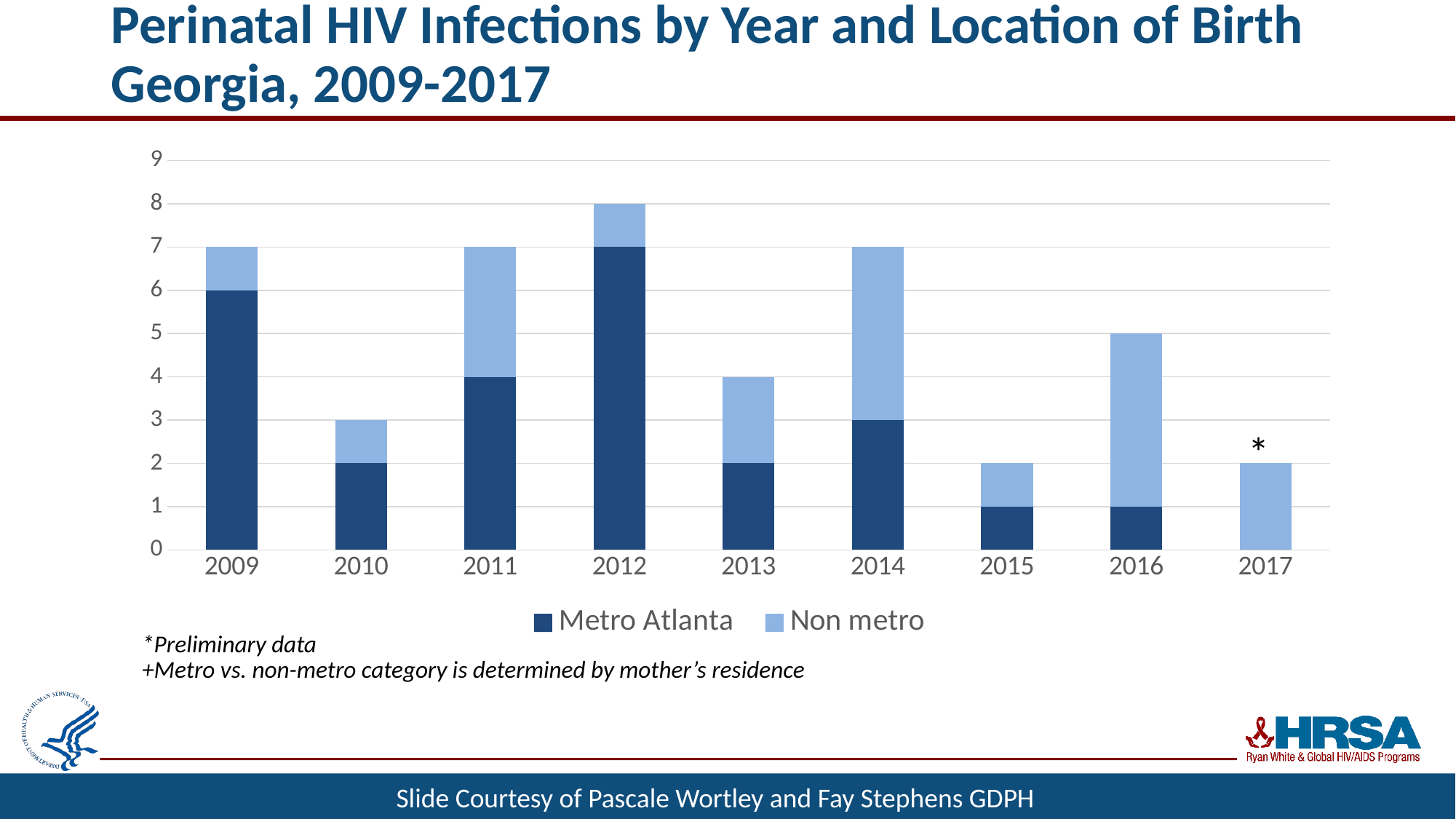
What is the total number of perinatal HIV infections in 2012? 8 Which year is marked with an asterisk indicating preliminary data? 2017 Is the Metro Atlanta value for 2014 larger or smaller than the Metro Atlanta value for 2011? smaller How many years are shown on the x axis? 9 What is the Metro Atlanta value for 2012? 7 Which year has the highest total number of perinatal HIV infections? 2012 What is the Metro Atlanta value for 2009? 6 How many series does the legend list? 2 What is the total number of infections in 2016? 5 What kind of chart is shown on the slide? stacked bar chart Is the total for 2010 greater or less than 5? less What is the Non metro value for 2014? 4